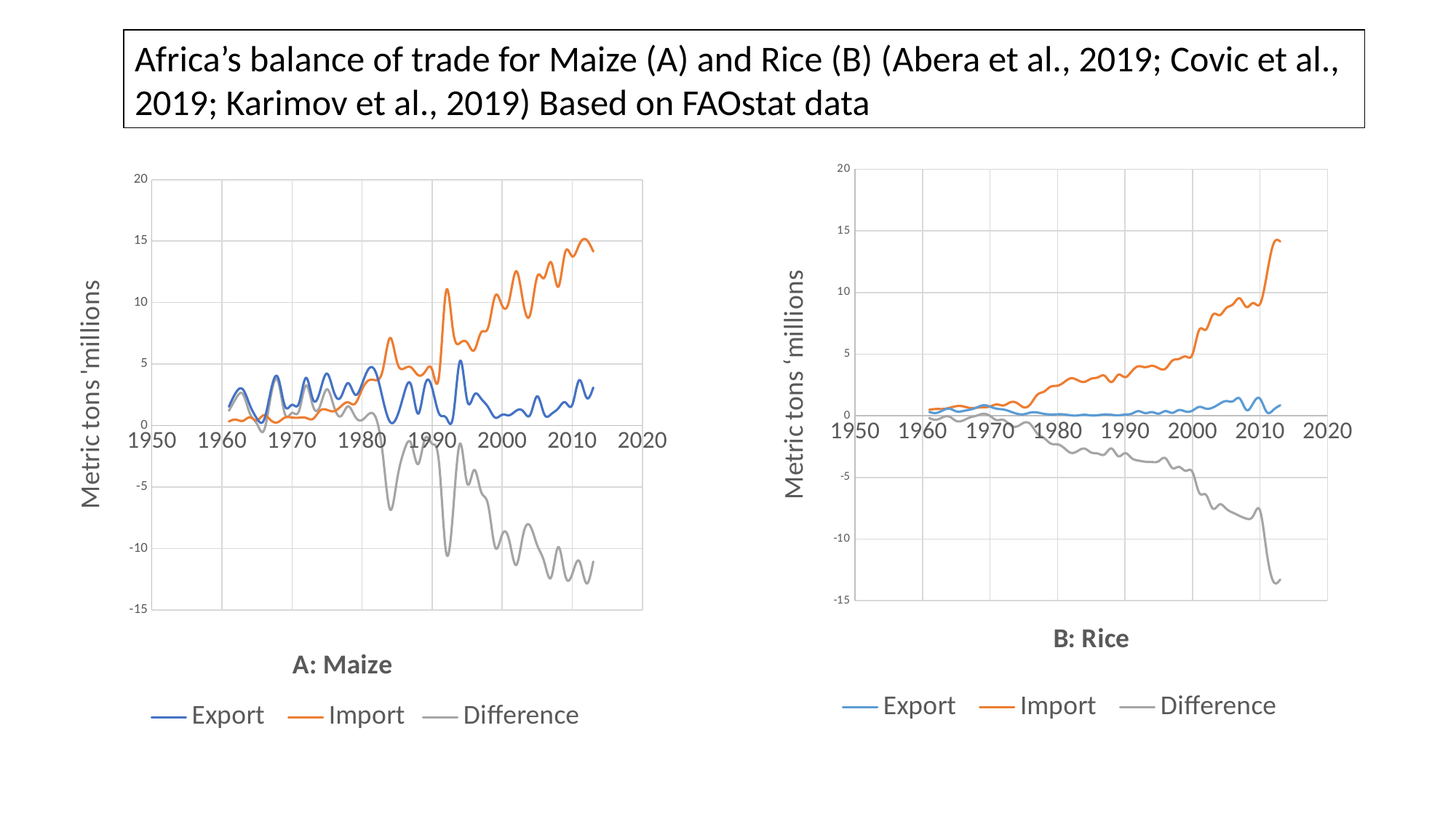
What kind of chart is the A: Maize chart? line chart In the B: Rice chart, does the Difference series generally rise or fall from 1960 to 2010? fall In the A: Maize chart, is the Import value around 2010 greater or less than 10? greater What kind of chart is the B: Rice chart? line chart What is the y-axis title of the B: Rice chart? Metric tons 'millions In the B: Rice chart, is the Import value around 2010 greater or less than 5? greater How many series does the legend of the B: Rice chart list? 3 How many series does the legend of the A: Maize chart list? 3 In the B: Rice chart, around 2010, which is larger, Import or Export? Import In the A: Maize chart, is the Export value around 2010 greater or less than 5? less In the A: Maize chart, does the Import series generally rise or fall from 1960 to 2010? rise What are the legend entries of the A: Maize chart? Export, Import, Difference